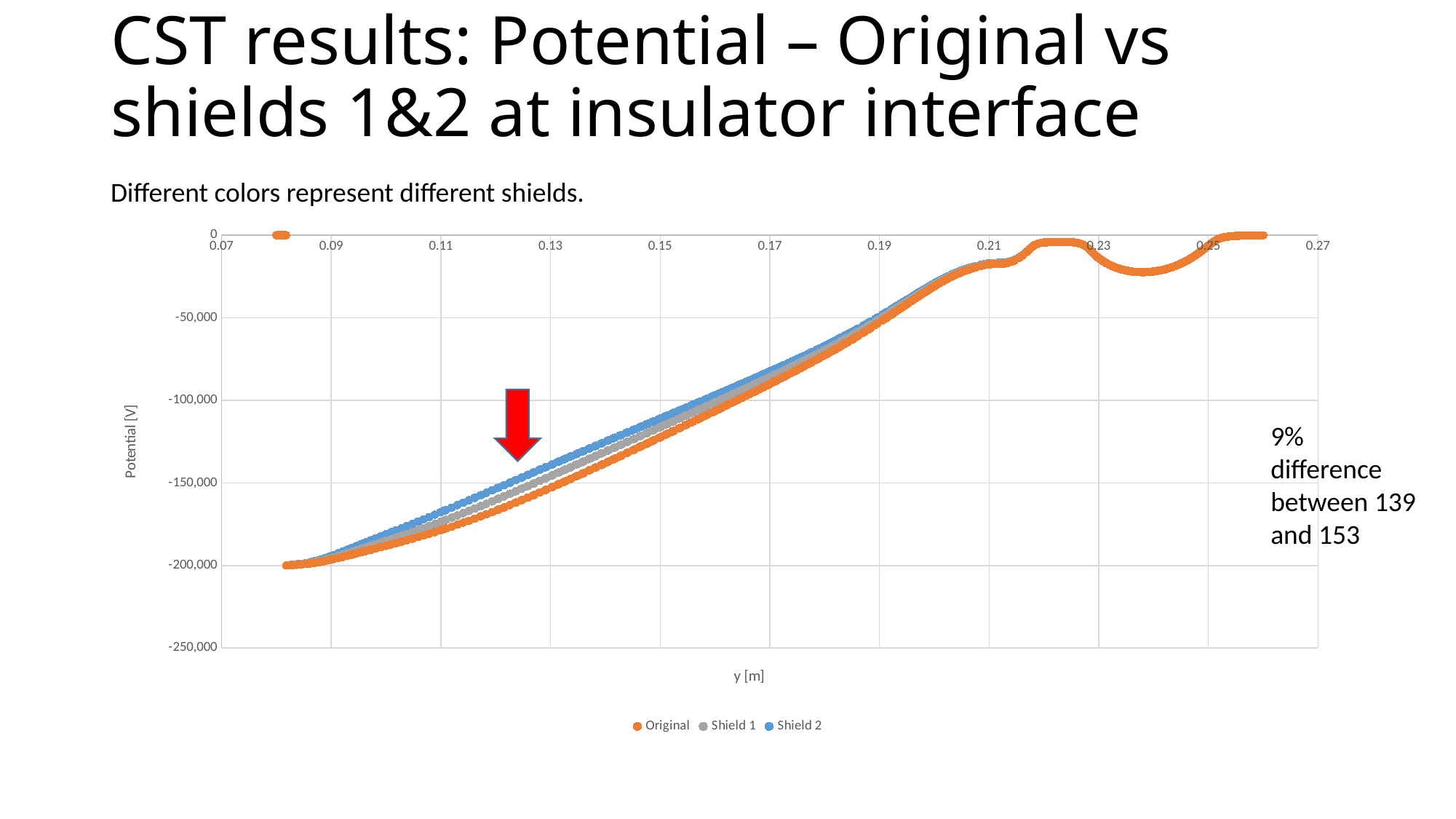
Is the Shield 2 potential at y = 0.09 m greater or less than -150,000? less Is the lowest potential reached by the Original series greater or less than -150,000? less Is the Original potential at y = 0.13 m greater or less than -100,000? less What are the names of the series in the legend? Original, Shield 1, Shield 2 What is the label of the vertical axis? Potential [V] Do the potential values rise or fall as y [m] increases from 0.09 to 0.21? rise How many series does the legend list? 3 At y = 0.13 m, which series has the lowest potential? Original At y = 0.13 m, which series has the higher potential, Shield 2 or Original? Shield 2 What kind of chart is shown on the slide? scatter chart